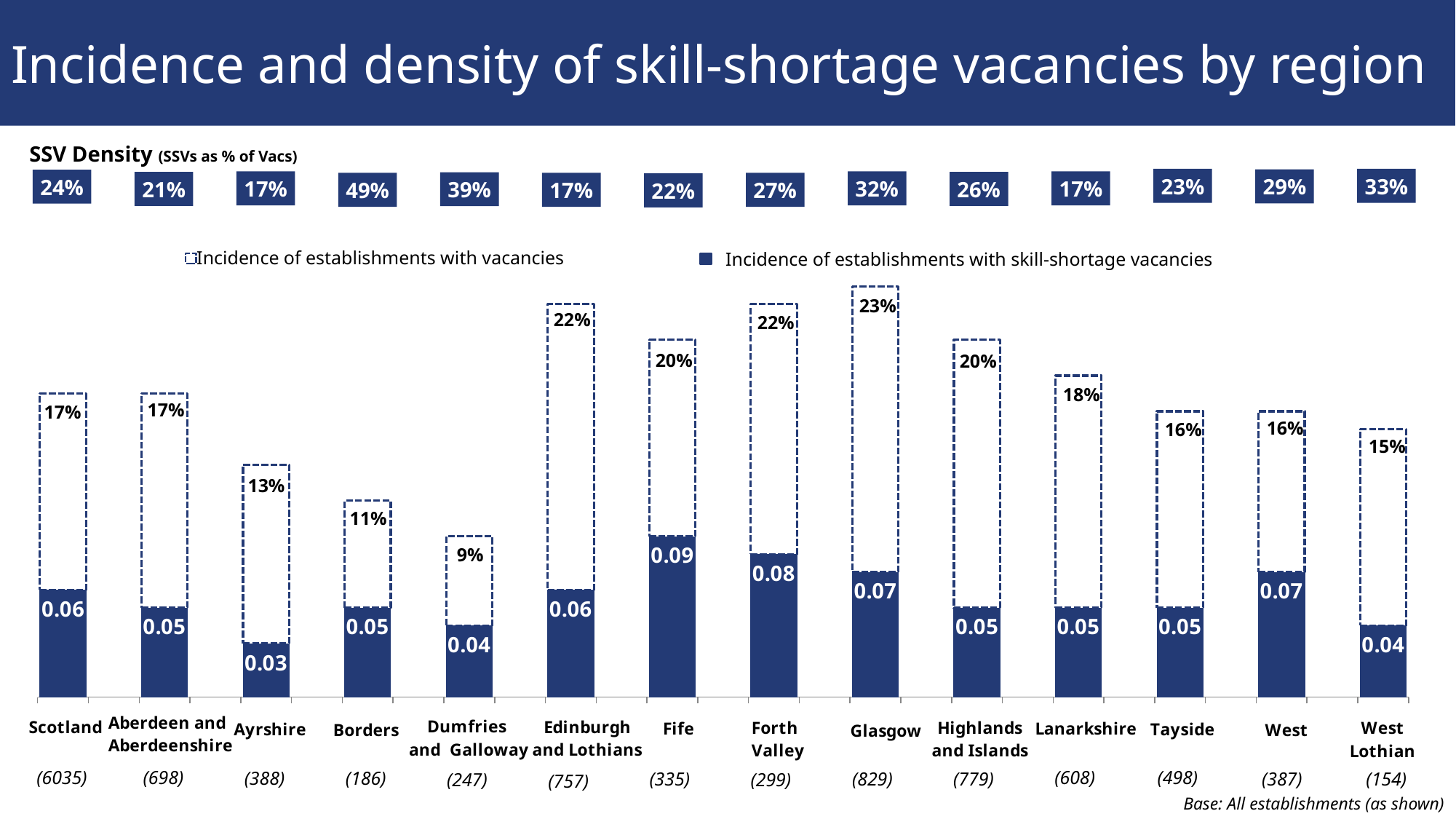
What is the difference in the incidence of establishments with vacancies between Glasgow and Dumfries and Galloway? 14 percentage points Which has a higher incidence of establishments with skill-shortage vacancies, Forth Valley or Tayside? Forth Valley How many series does the chart legend list? 2 What type of chart is shown on the slide? Bar chart What is the SSV density (SSVs as % of vacancies) shown for Borders? 49% What is the incidence of establishments with skill-shortage vacancies in Fife? 0.09 How many regions are shown on the x axis of the chart? 14 Which region has the highest incidence of establishments with vacancies? Glasgow Which region has the lowest incidence of establishments with vacancies? Dumfries and Galloway Which region has the lowest incidence of establishments with skill-shortage vacancies? Ayrshire What is the incidence of establishments with vacancies in Edinburgh and Lothians? 22% What is the base number of establishments shown for Scotland? 6035